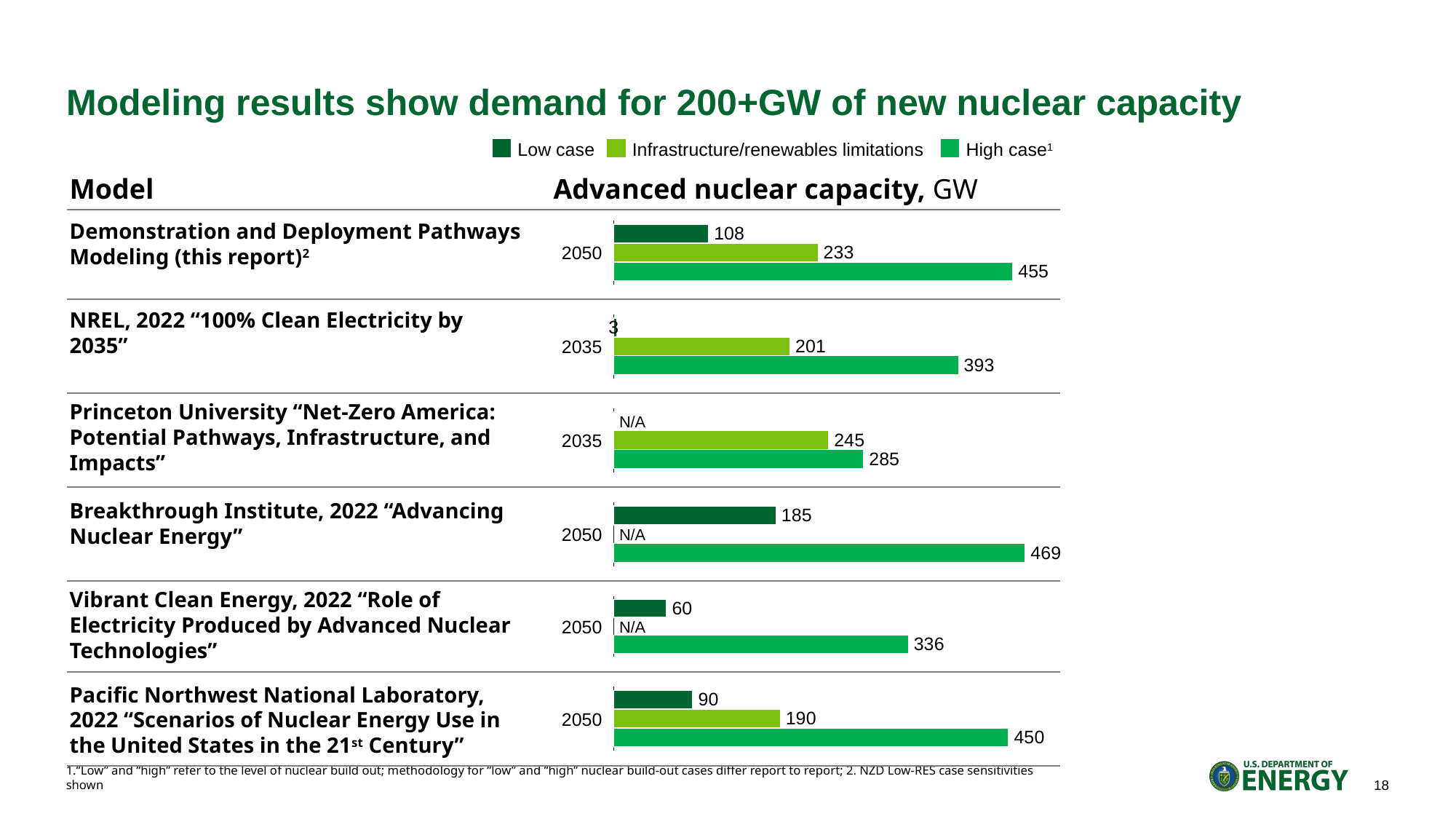
In the Princeton University "Net-Zero America" chart, what is the High case value for 2035? 285 In the Pacific Northwest National Laboratory, 2022 chart, what is the difference between the High case and Low case values? 360 In the Demonstration and Deployment Pathways Modeling (this report) chart, what is the difference between the High case and the Infrastructure/renewables limitations values? 222 In the NREL, 2022 "100% Clean Electricity by 2035" chart, what is the Infrastructure/renewables limitations value? 201 Which chart shows the highest High case value across all models? Breakthrough Institute, 2022 "Advancing Nuclear Energy" What kind of chart is used to show the advanced nuclear capacity values? Bar chart Which is larger: the Infrastructure/renewables limitations value in the Princeton University chart or in the Pacific Northwest National Laboratory chart? Princeton University In the Demonstration and Deployment Pathways Modeling (this report) chart, what is the High case value for 2050? 455 In the Demonstration and Deployment Pathways Modeling (this report) chart, what is the Low case value? 108 In the Breakthrough Institute, 2022 "Advancing Nuclear Energy" chart, what is the Low case value? 185 How many series does the legend list? 3 In the Vibrant Clean Energy, 2022 chart, what is the High case value for 2050? 336